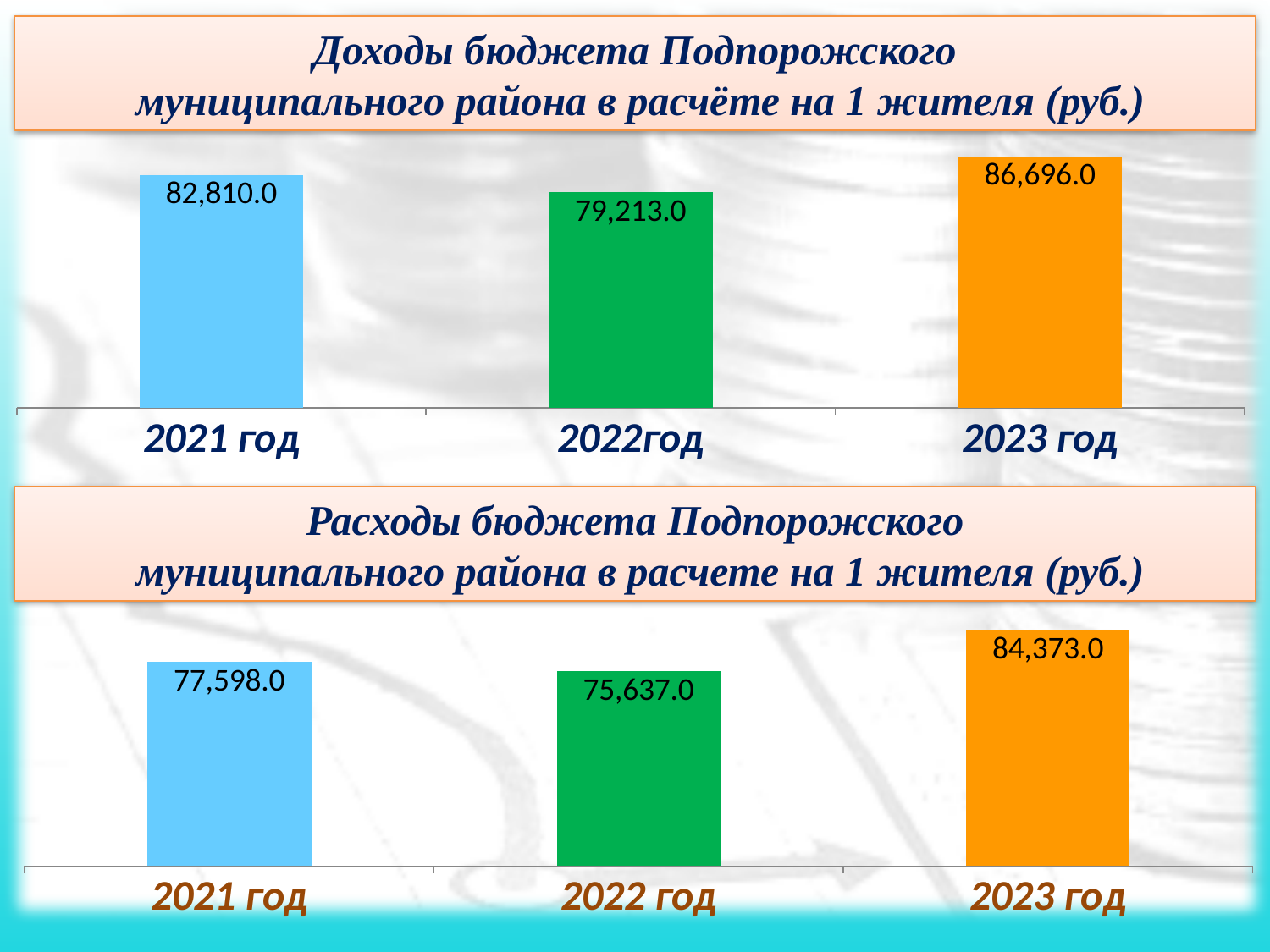
What type of chart is the bottom chart (Расходы бюджета)? Bar chart In the bottom chart (Расходы бюджета), which is larger: the value for 2021 год or 2022 год? 2021 год In the bottom chart (Расходы бюджета), which year has the lowest value? 2022 год In the top chart (Доходы бюджета), what is the value for 2022год? 79,213.0 In the bottom chart (Расходы бюджета), what is the value for 2023 год? 84,373.0 In the bottom chart (Расходы бюджета), what is the difference between the values for 2023 год and 2022 год? 8,736.0 In the top chart (Доходы бюджета), what is the value for 2021 год? 82,810.0 In the top chart (Доходы бюджета), which year has the highest value? 2023 год In the bottom chart (Расходы бюджета), what is the value for 2022 год? 75,637.0 What colour is the bar for 2023 год in the top chart (Доходы бюджета)? Orange How many bars are in the top chart (Доходы бюджета)? 3 In the top chart (Доходы бюджета), what is the difference between the values for 2023 год and 2021 год? 3,886.0